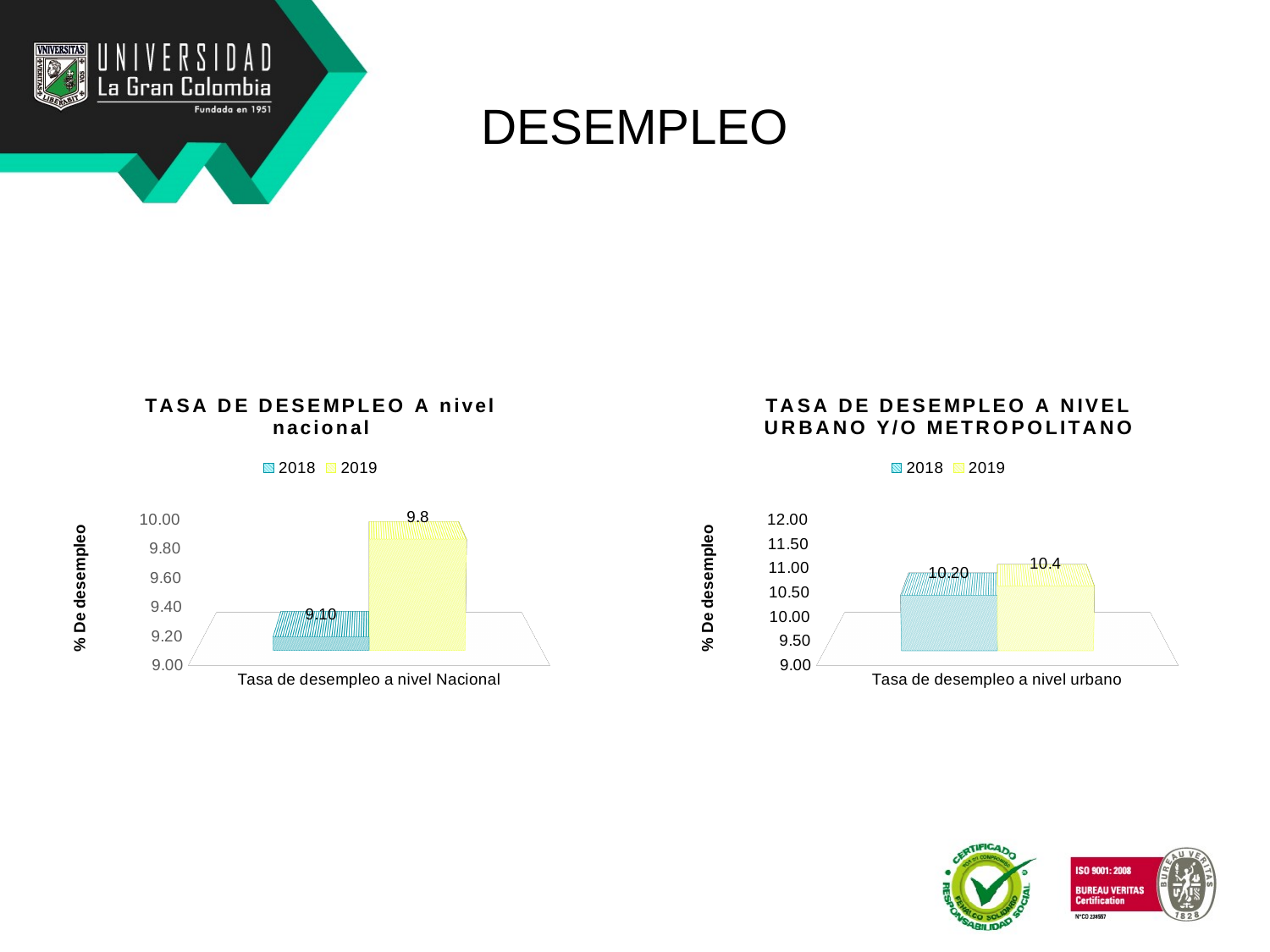
In the right chart (nivel urbano), what is the difference between the 2019 and 2018 values? 0.2 In the left chart (nivel nacional), what is the difference between the 2019 and 2018 values? 0.7 What kind of chart is the right chart (nivel urbano)? bar chart What is the y-axis label of the left chart (nivel nacional)? % De desempleo In the chart titled 'TASA DE DESEMPLEO A NIVEL URBANO Y/O METROPOLITANO', what is the value for 2018? 10.20 In the right chart (nivel urbano), is the value for 2019 greater or less than 11.00? less In the right chart (nivel urbano), which year has the lower unemployment rate? 2018 In the chart titled 'TASA DE DESEMPLEO A nivel nacional', what is the value for 2018? 9.10 In the chart titled 'TASA DE DESEMPLEO A NIVEL URBANO Y/O METROPOLITANO', what is the value for 2019? 10.4 In the left chart (nivel nacional), which year has the higher unemployment rate? 2019 How many series does the legend of the left chart (nivel nacional) list? 2 In the chart titled 'TASA DE DESEMPLEO A nivel nacional', what is the value for 2019? 9.8